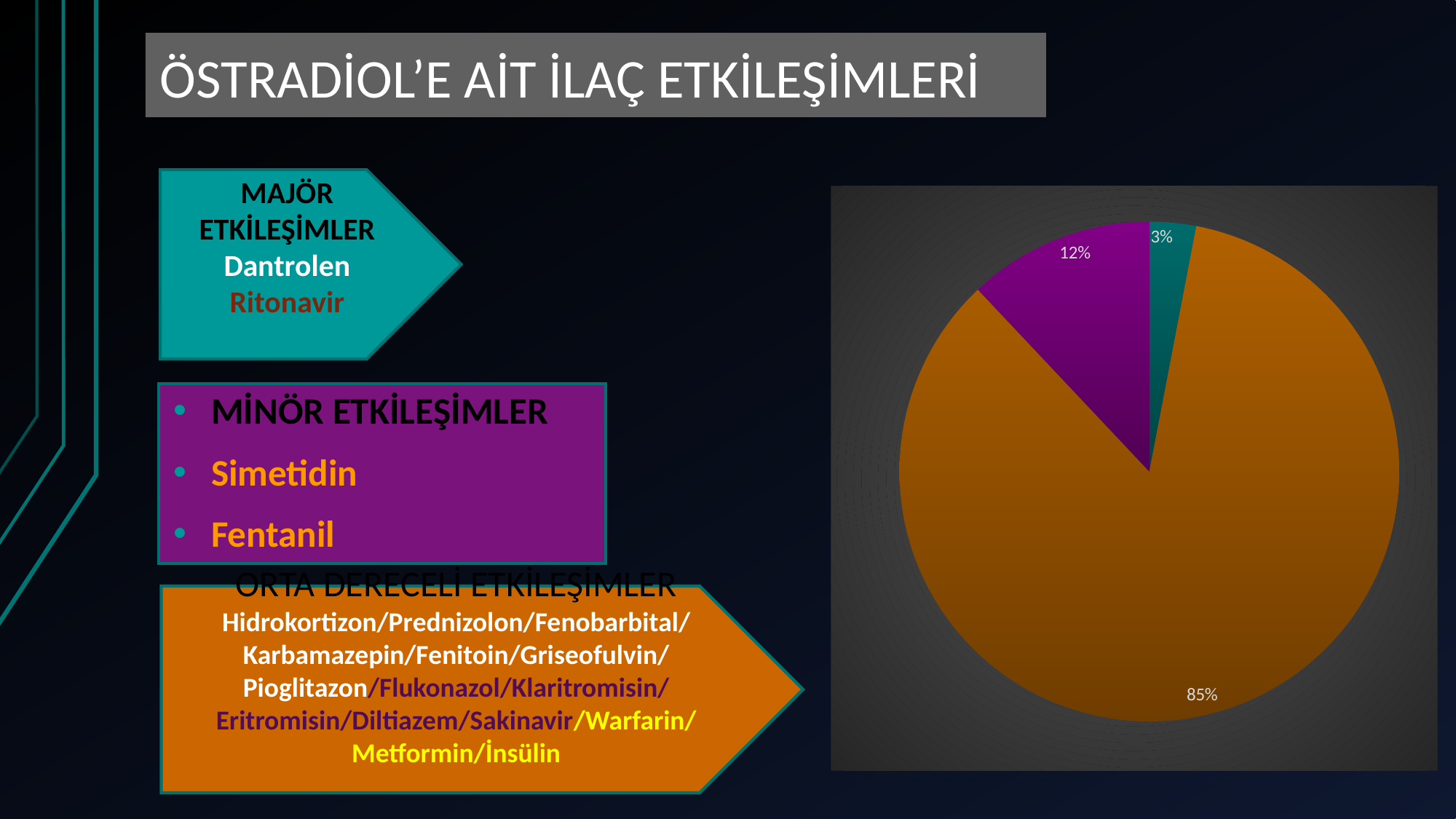
Which slice is larger in the pie chart, the purple one or the teal one? the purple one What kind of chart is shown on the slide? pie chart What percentage is shown on the purple slice of the pie chart? 12% What is the difference between the purple slice and the teal slice in the pie chart? 9% How many slices does the pie chart have? 3 What percentage is shown on the teal slice of the pie chart? 3% What is the difference between the largest and the smallest slice values in the pie chart? 82% What is the value shown on the largest slice of the pie chart? 85% What is the value shown on the smallest slice of the pie chart? 3% What colour is the largest slice of the pie chart? orange What percentage is shown on the orange slice of the pie chart? 85% Does the pie chart have a legend? No